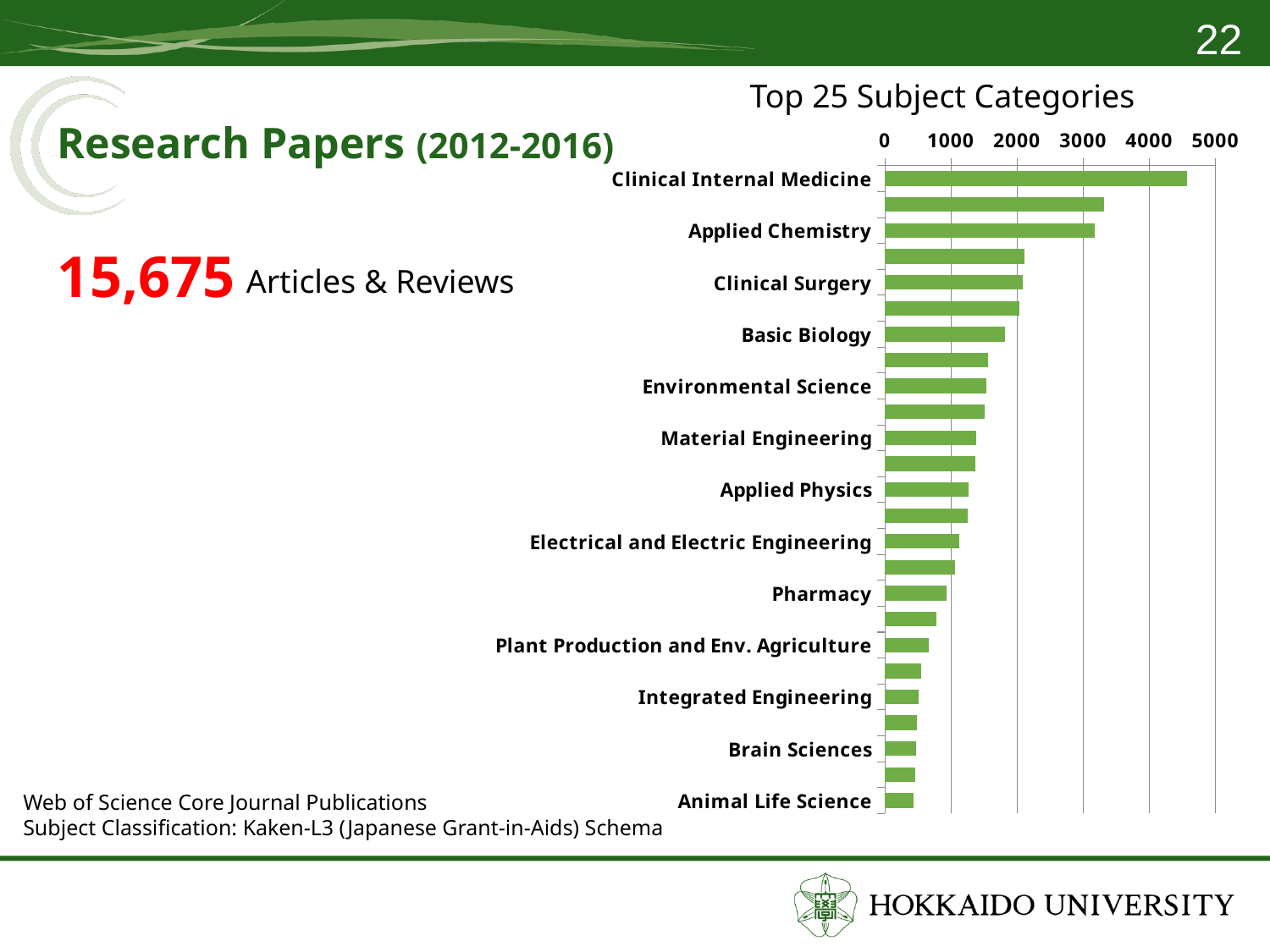
Is the value for Applied Chemistry greater or less than 3000? greater Do the bar values increase or decrease going from the top of the chart to the bottom? Decrease Is the value for Basic Biology greater or less than 2000? less What kind of chart is shown on the slide? Bar chart Which labelled subject category has the lowest value in the chart? Animal Life Science Is the value for Clinical Internal Medicine greater or less than 4000? greater Which has the larger value, Clinical Internal Medicine or Applied Chemistry? Clinical Internal Medicine Which subject category has the highest value in the chart? Clinical Internal Medicine How many bars are plotted in the chart? 25 What is the title of the chart? Top 25 Subject Categories